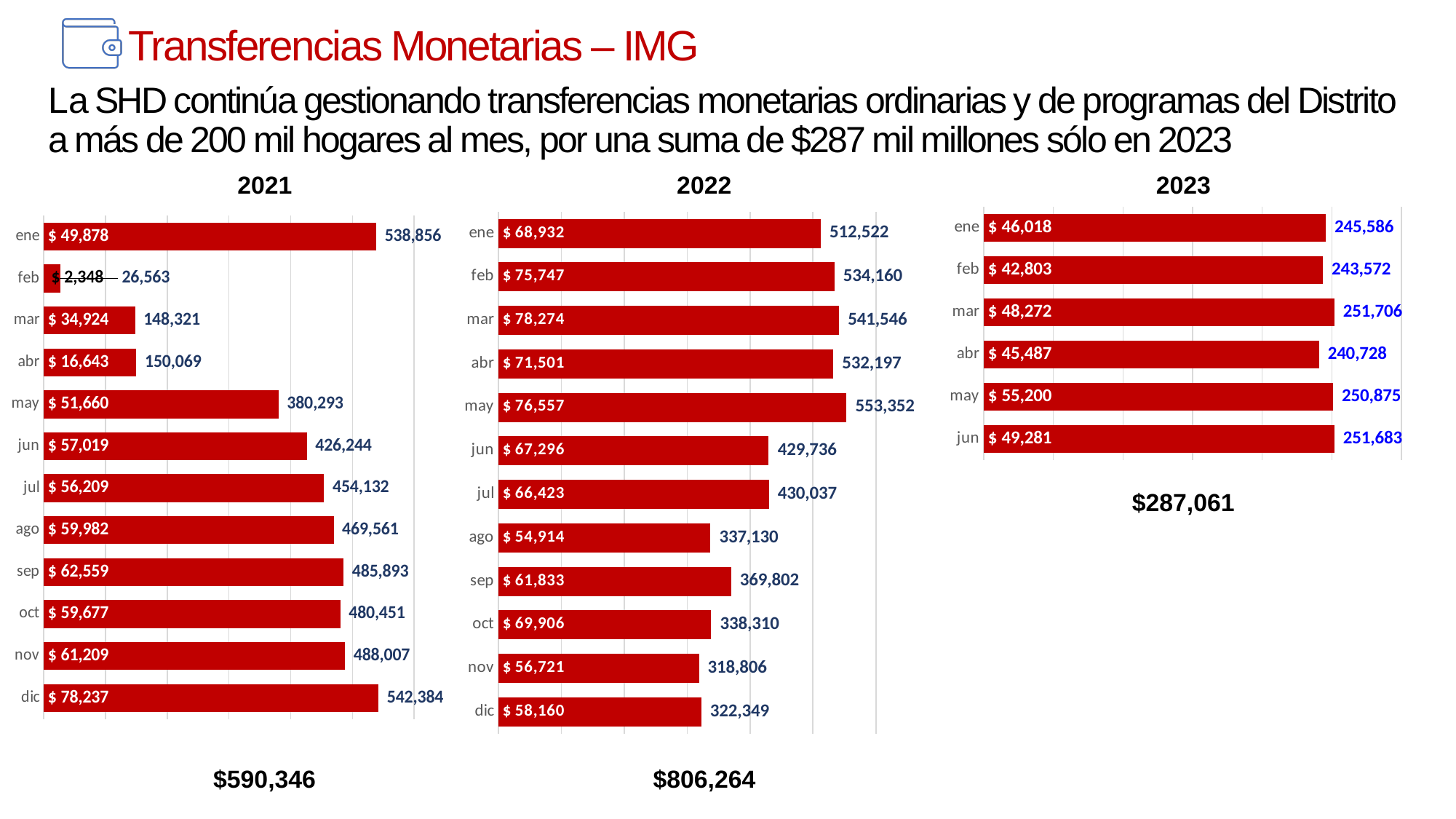
What kind of chart is used for the 2022 data? bar chart What total is printed below the 2022 chart? $806,264 In the 2021 chart, what value is printed at the end of the bar for dic? 542,384 How many months are shown in the 2023 chart? 6 In the 2021 chart, which is larger, the value for jun or the value for jul? jul In the 2022 chart, which month has the longest bar? may In the 2023 chart, what dollar amount is printed inside the bar for may? $ 55,200 In the 2022 chart, what dollar amount is printed inside the bar for mar? $ 78,274 In the 2022 chart, which month has the shortest bar? nov How many bars are in the 2021 chart? 12 In the 2021 chart, which month has the shortest bar? feb In the 2022 chart, what is the difference between the values printed at the end of the bars for ene and dic? 190,173